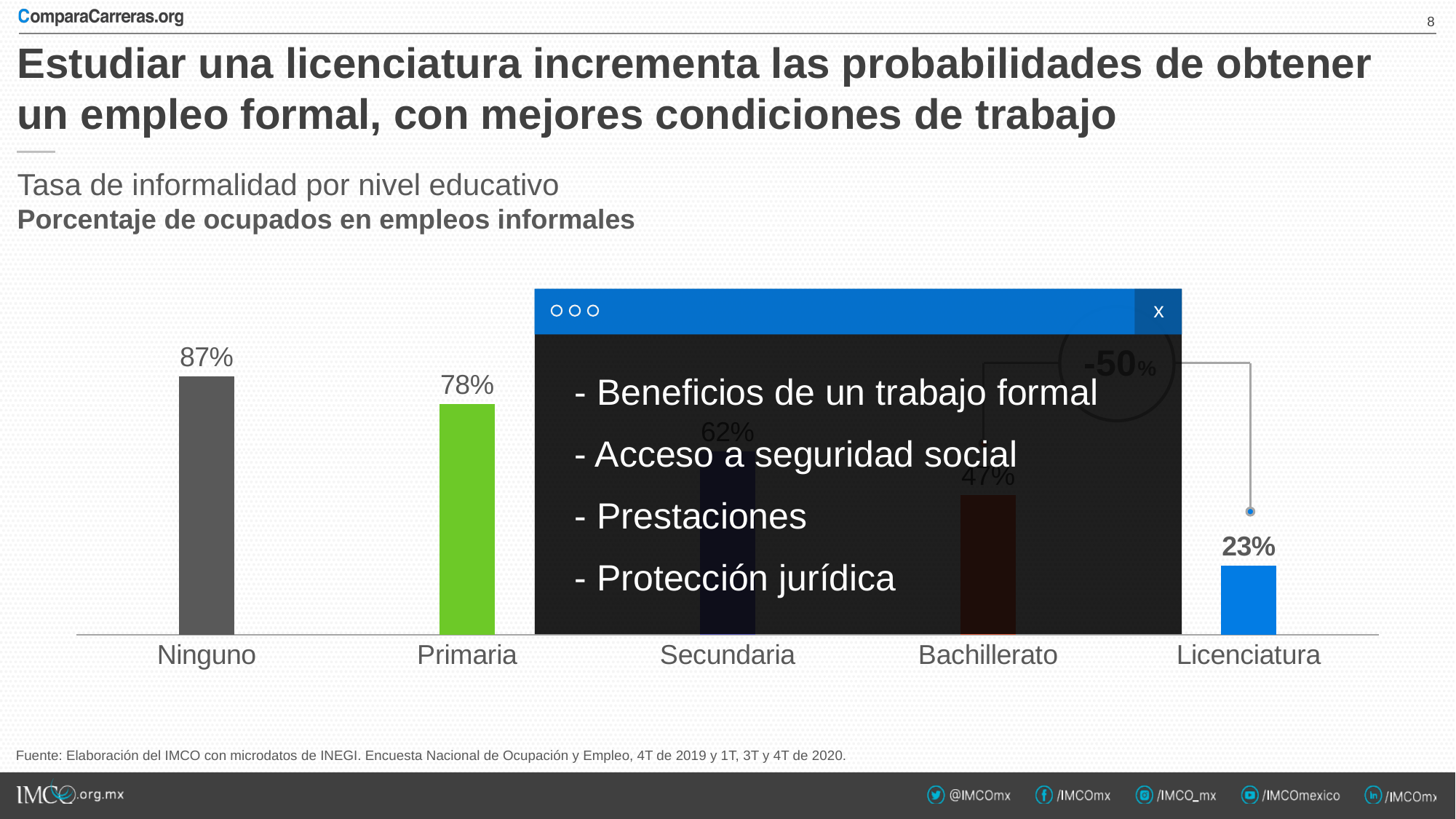
What kind of chart is shown on the slide? Bar chart Do the informality rates rise or fall as education level increases from Ninguno to Licenciatura? Fall What is the difference between the informality rates for Ninguno and Licenciatura? 64% How many education levels are shown on the x axis of the chart? 5 Which education level has the lowest informality rate? Licenciatura What is the informality rate for Primaria? 78% What is the difference between the informality rates for Ninguno and Primaria? 9% What is the title of the chart? Tasa de informalidad por nivel educativo What is the informality rate for Ninguno? 87% What is the informality rate for Licenciatura? 23% Which has a higher informality rate, Primaria or Licenciatura? Primaria Which education level has the highest informality rate? Ninguno